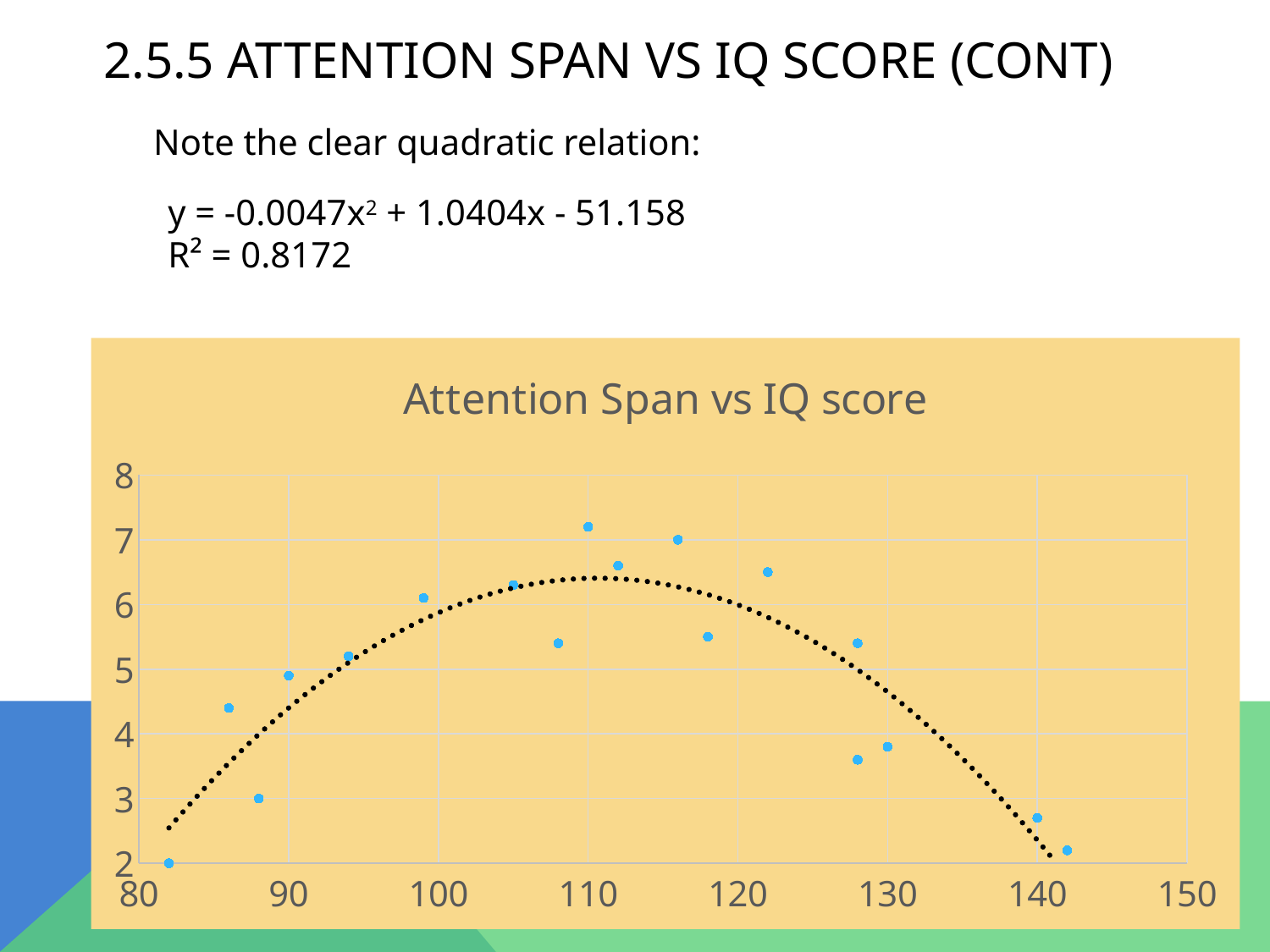
What is the title of the chart? Attention Span vs IQ score Is the attention span value for the point at IQ score 142 greater or less than 3? less Which has the lower attention span value: the point at IQ score 90 or the point at IQ score 116? the point at IQ score 90 Which has the higher attention span value: the point at IQ score 110 or the point at IQ score 140? the point at IQ score 110 What range does the horizontal (IQ score) axis cover? 80 to 150 How do the attention span values change as IQ score increases from 80 to 150? they rise and then fall What kind of chart is shown on the slide? scatter chart Is the attention span value for the point at IQ score 99 greater or less than 5? greater Is the attention span value for the point at IQ score 88 greater or less than 4? less How many data points are plotted on the chart? 18